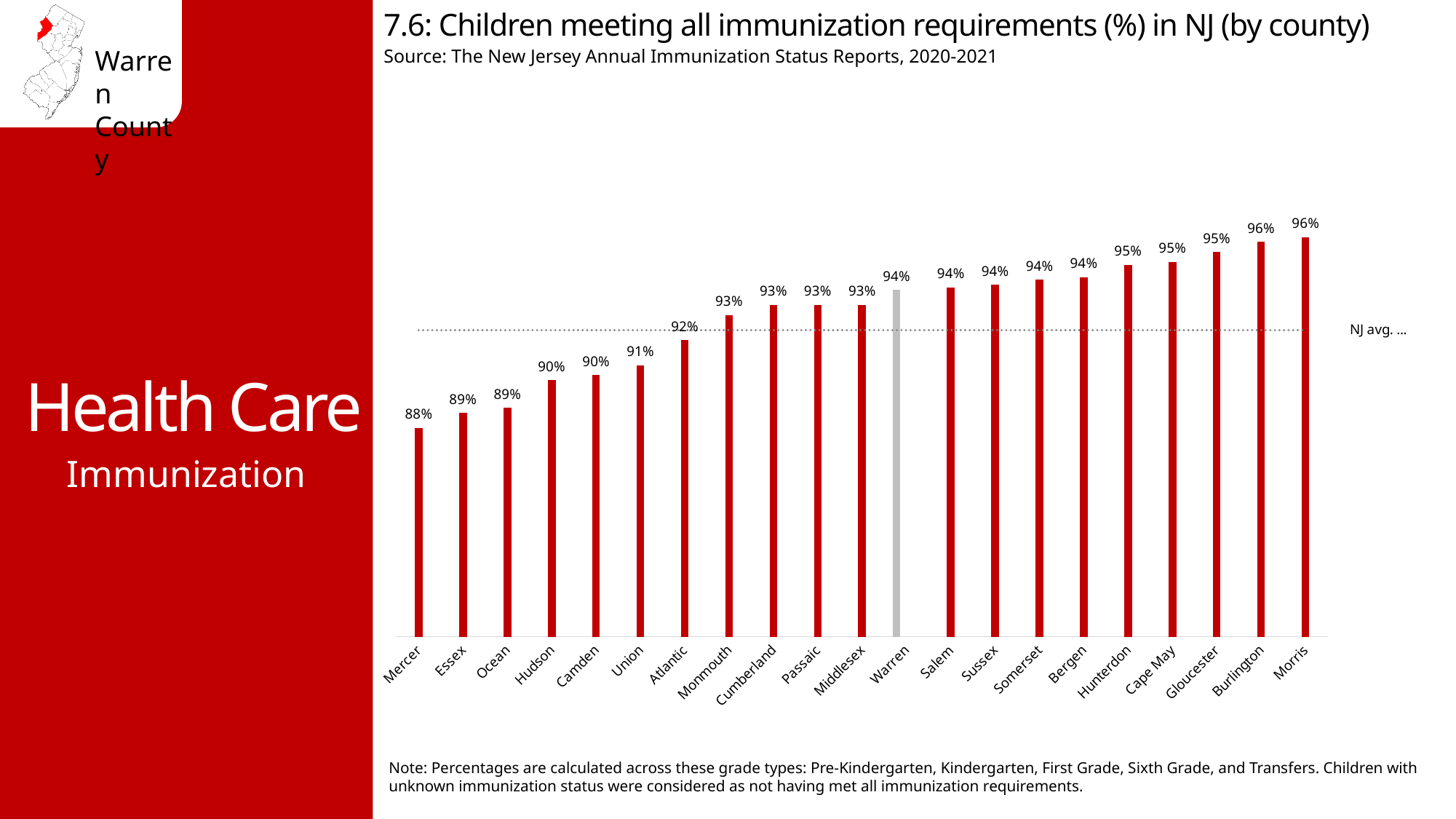
Do the values rise or fall moving from left to right along the x axis? Rise Which county has the lowest percentage of children meeting all immunization requirements? Mercer Which has a higher value, Warren County or Union County? Warren Which two counties share the highest value on the chart? Burlington and Morris What is the value shown for Mercer County? 88% What percentage is shown for Atlantic County? 92% What is the difference in percentage points between Morris County and Mercer County? 8 What is the value for Hunterdon County? 95% What percentage of children in Warren County met all immunization requirements? 94% What is the difference in percentage points between Warren County and Mercer County? 6 How many counties are shown on the chart? 21 What kind of chart is used on this slide? Bar chart